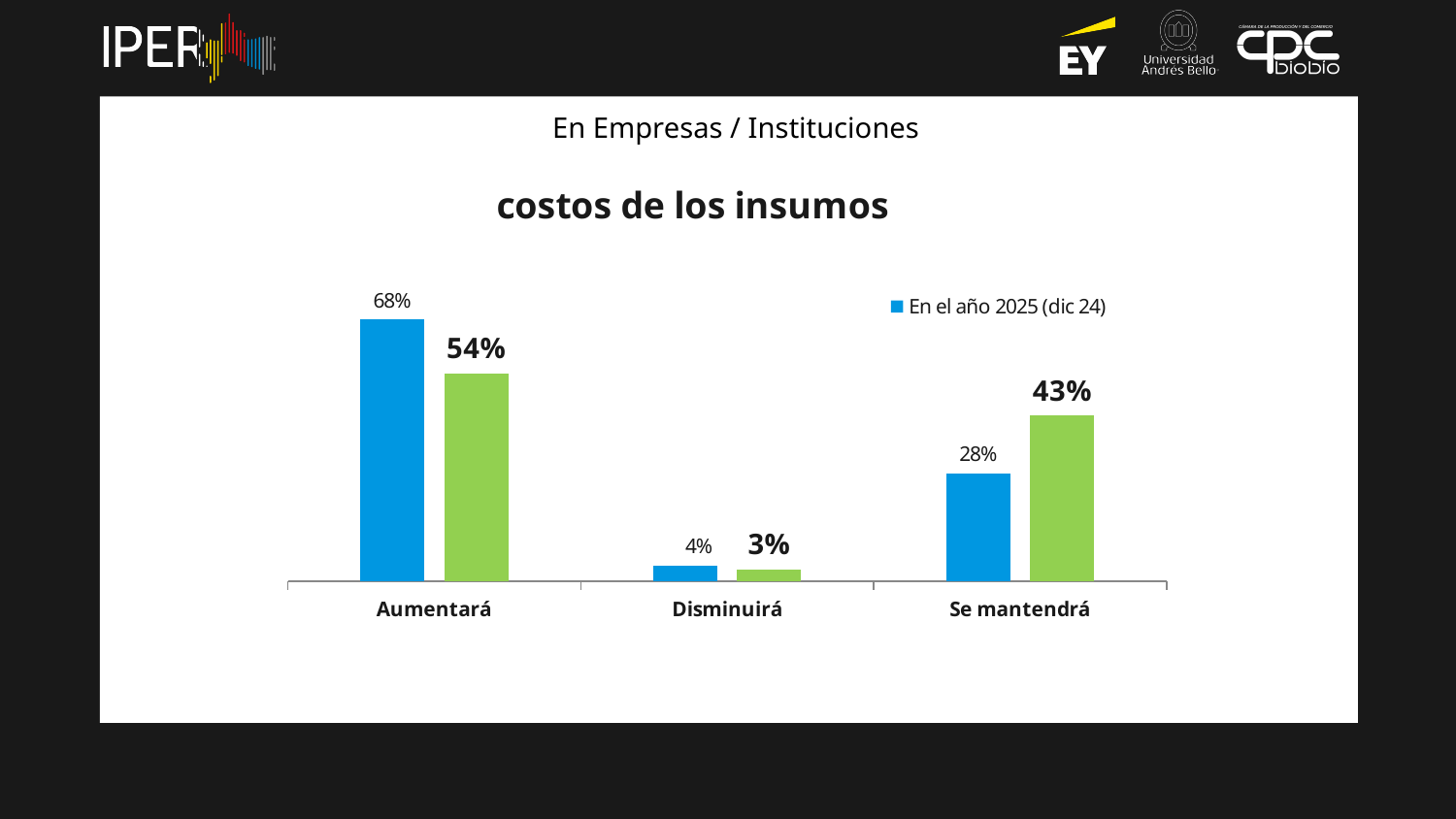
How many categories are shown on the x axis? 3 What is the value of the 'En el año 2025 (dic 24)' series for Disminuirá? 4% What is the value of the green bar for Aumentará? 54% How many series does the legend list? 1 Which category has the highest value in the 'En el año 2025 (dic 24)' series? Aumentará What is the value of the green bar for Se mantendrá? 43% What kind of chart is shown on the slide? bar chart Which category has the lowest value among the green bars? Disminuirá What is the value of the 'En el año 2025 (dic 24)' series for Aumentará? 68% What is the difference between the blue and green bars for Se mantendrá? 15% For Aumentará, which is larger: the blue bar or the green bar? the blue bar What is the title of the chart? costos de los insumos